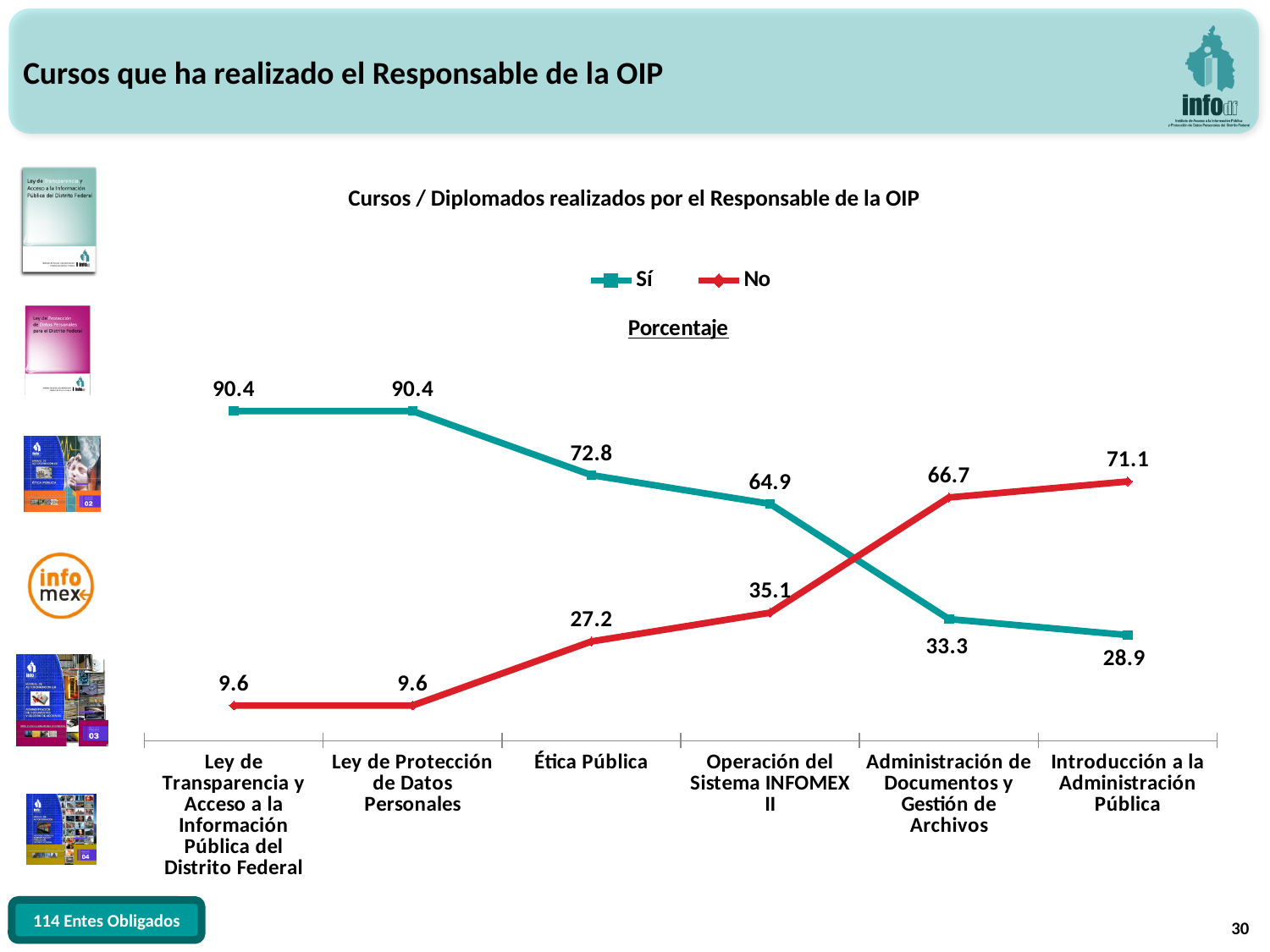
Which category has the highest 'No' value? Introducción a la Administración Pública What is the 'No' value for Introducción a la Administración Pública? 71.1 What is the difference between the 'Sí' and 'No' values for Administración de Documentos y Gestión de Archivos? 33.4 Does the 'Sí' series rise or fall from left to right along the x axis? Fall How many series does the legend list? 2 How many categories are shown on the x axis? 6 What is the 'Sí' value for Operación del Sistema INFOMEX II? 64.9 What kind of chart is shown on the slide? Line chart Which category has the lowest 'Sí' value? Introducción a la Administración Pública What is the 'No' value for Ley de Protección de Datos Personales? 9.6 Which is larger for Ética Pública, the 'Sí' value or the 'No' value? Sí What is the 'Sí' value for Ética Pública? 72.8